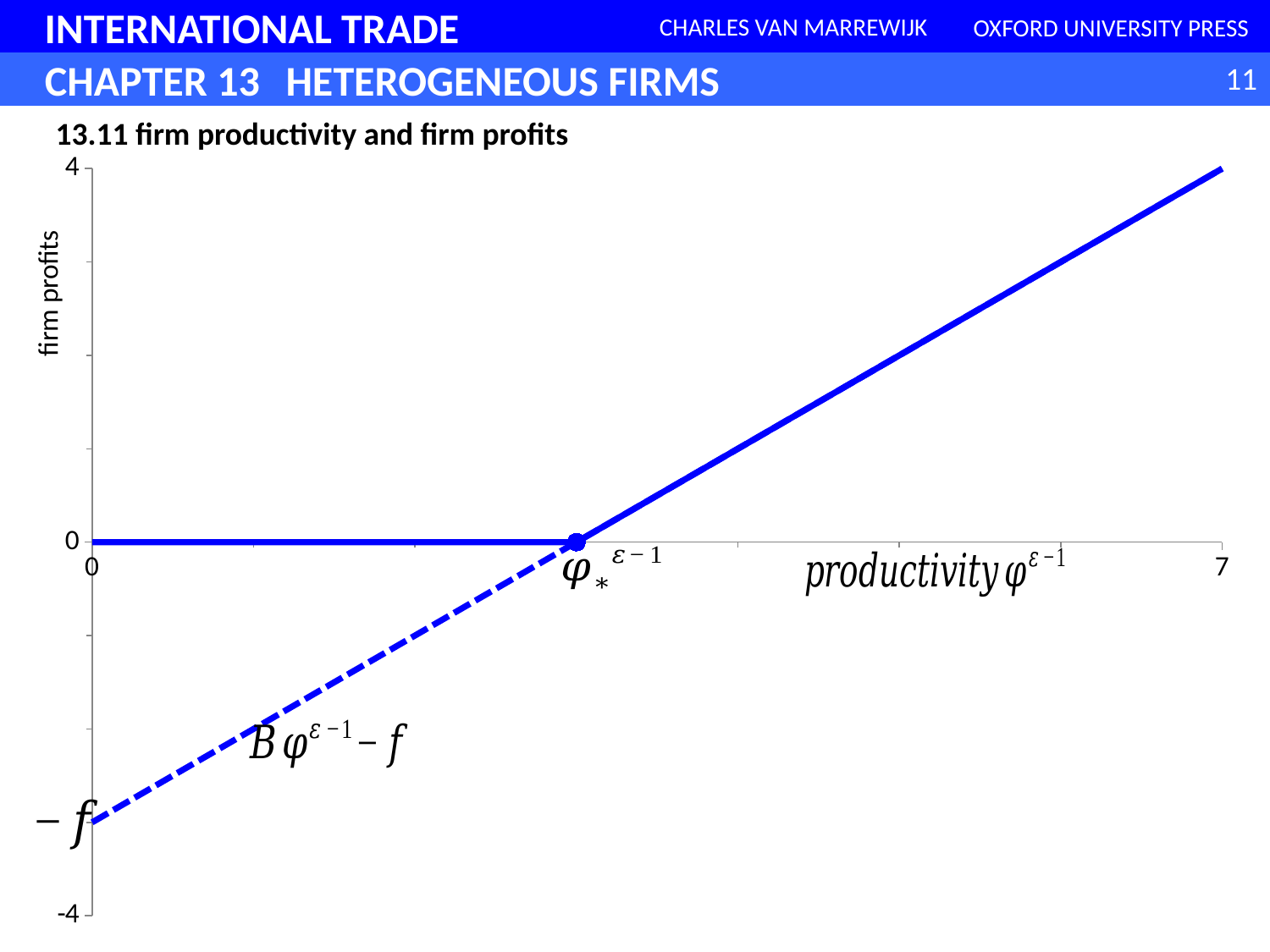
Do firm profits rise or fall as productivity increases beyond the threshold φ*^(ε−1)? rise What is the label on the vertical axis of the chart? firm profits Which is larger: the solid line's value at productivity 7 or its value at productivity 0? at productivity 7 Is the value of the dashed line at productivity 0 greater or less than -4? greater What kind of chart is shown on the slide? line chart What is the lowest value shown on the vertical axis? -4 Is the value of the dashed line at productivity 0 greater or less than 0? less What is the maximum value shown on the horizontal axis? 7 What is the value of the solid profit line for productivity levels below φ*^(ε−1)? 0 Is the value of the solid profit line at productivity 7 greater or less than 0? greater